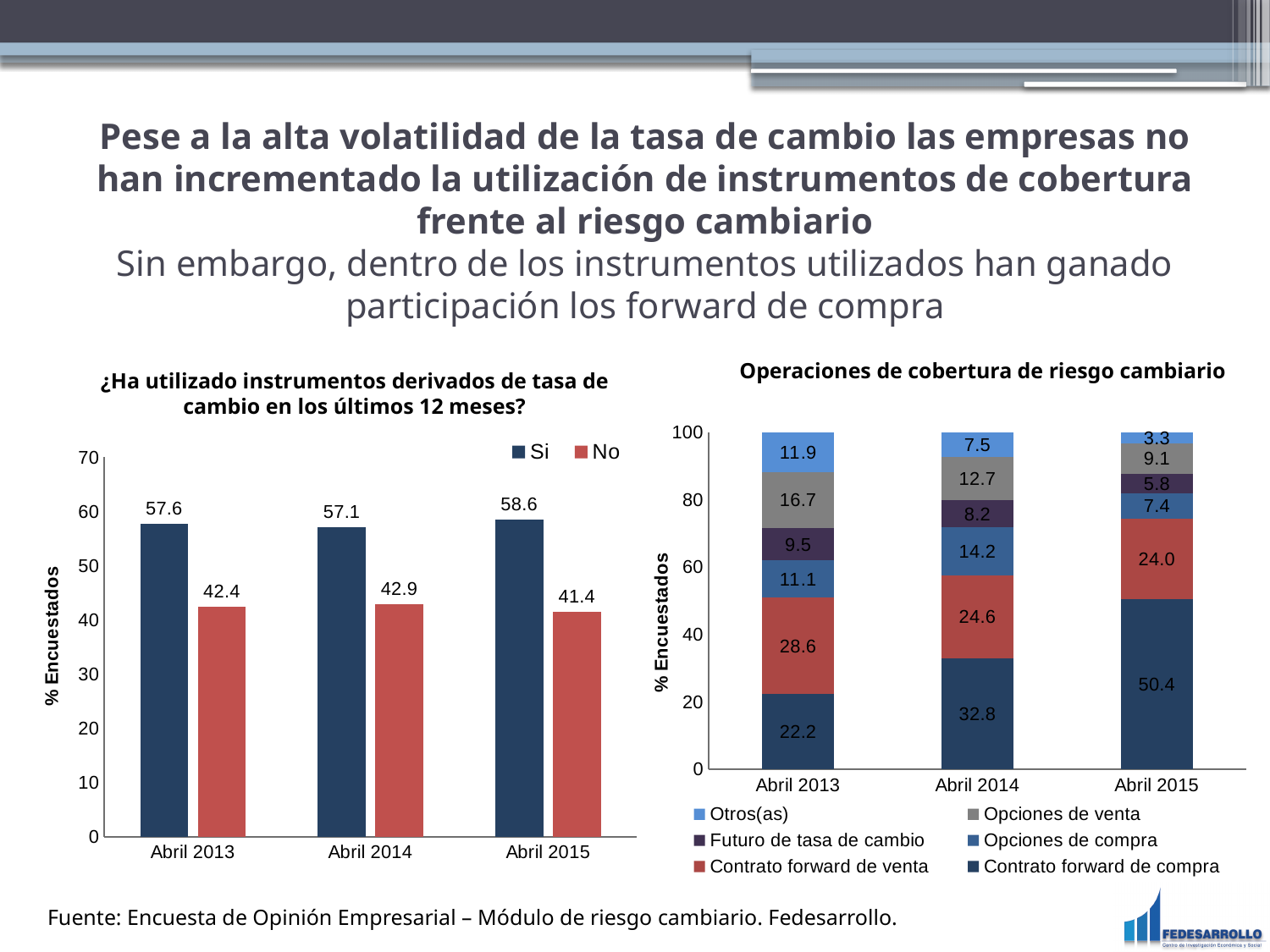
In the left chart '¿Ha utilizado instrumentos derivados de tasa de cambio en los últimos 12 meses?', what is the value for 'No' in Abril 2013? 42.4 In the left chart '¿Ha utilizado instrumentos derivados de tasa de cambio en los últimos 12 meses?', what is the value for 'Si' in Abril 2015? 58.6 In the left chart '¿Ha utilizado instrumentos derivados de tasa de cambio en los últimos 12 meses?', in which year is the 'Si' value highest? Abril 2015 In the left chart '¿Ha utilizado instrumentos derivados de tasa de cambio en los últimos 12 meses?', what is the difference between 'Si' and 'No' in Abril 2014? 14.2 In the right chart 'Operaciones de cobertura de riesgo cambiario', how many series does the legend list? 6 In the right chart 'Operaciones de cobertura de riesgo cambiario', does the value for 'Contrato forward de compra' rise or fall from Abril 2013 to Abril 2015? rise In the right chart 'Operaciones de cobertura de riesgo cambiario', what is the total of the stacked bar for Abril 2014? 100.0 In the right chart 'Operaciones de cobertura de riesgo cambiario', what is the value for 'Contrato forward de compra' in Abril 2015? 50.4 In the right chart 'Operaciones de cobertura de riesgo cambiario', which is larger in Abril 2014: 'Contrato forward de compra' or 'Contrato forward de venta'? Contrato forward de compra In the left chart '¿Ha utilizado instrumentos derivados de tasa de cambio en los últimos 12 meses?', how many series does the legend list? 2 What kind of chart is the right chart 'Operaciones de cobertura de riesgo cambiario'? stacked bar chart In the right chart 'Operaciones de cobertura de riesgo cambiario', what is the value for 'Opciones de venta' in Abril 2013? 16.7